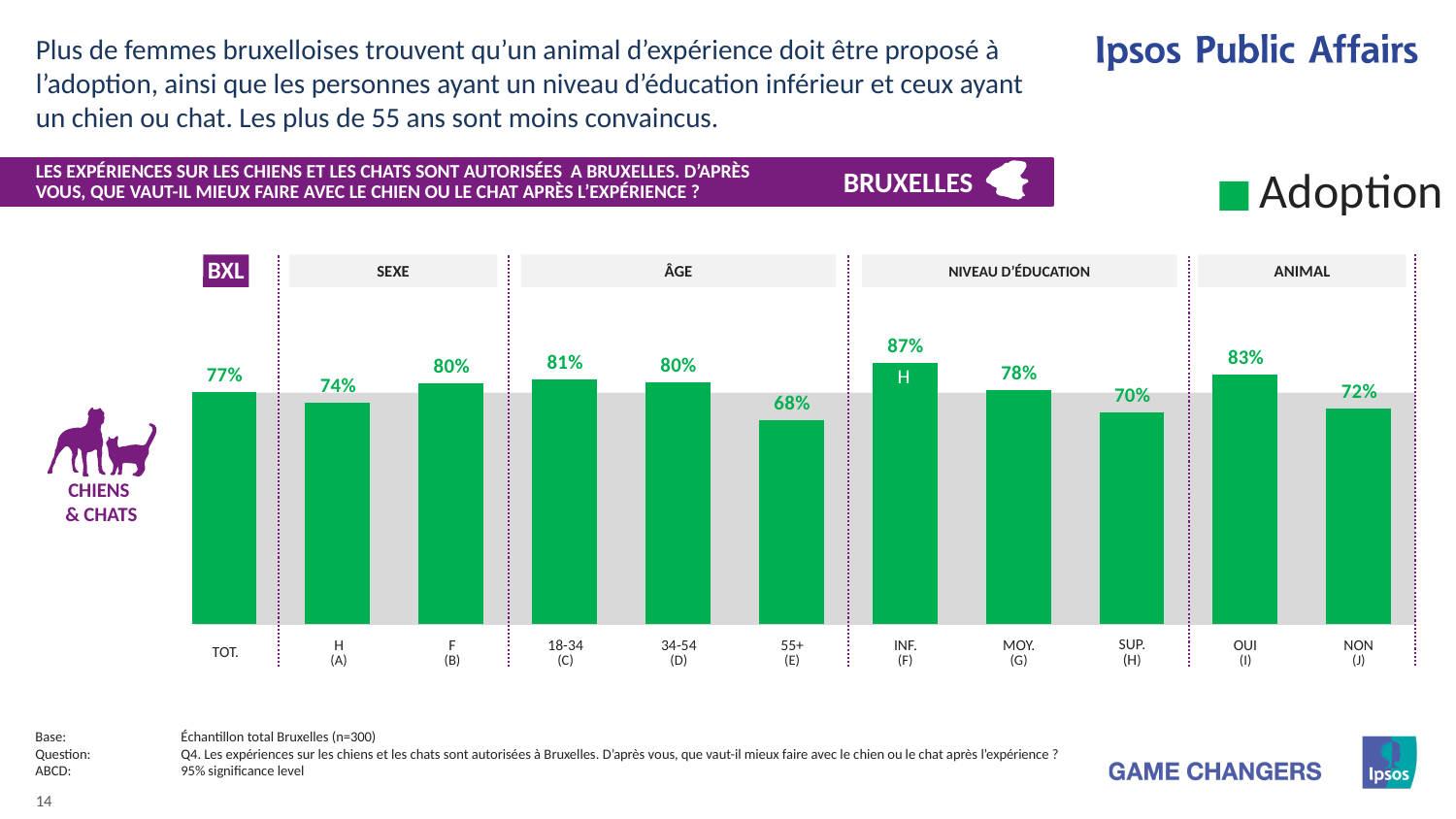
What is the difference between the values for OUI and NON under ANIMAL? 11% What is the value for NON under ANIMAL? 72% What kind of chart is shown on the slide? Bar chart Which is larger, the value for 18-34 or the value for 55+? 18-34 What is the value for the 55+ age group? 68% How many series does the legend list? 1 Which category has the highest value on the chart? INF. (F) What is the value for TOT. (total Brussels)? 77% What is the difference between the values for F and H under SEXE? 6% What is the value for INF. (lower education level)? 87% Which category has the lowest value on the chart? 55+ (E) How many bars are plotted on the chart? 11